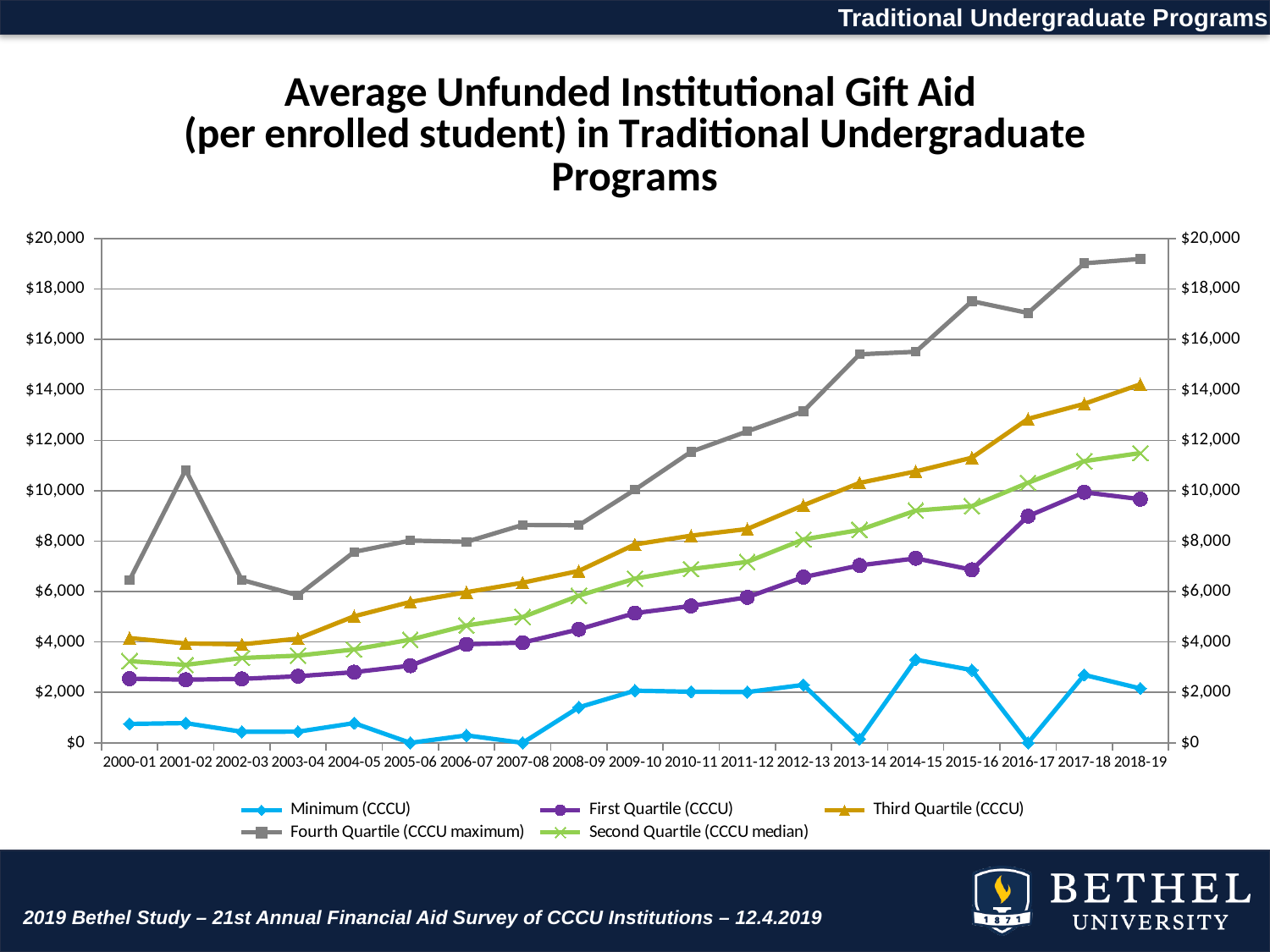
Is the Third Quartile (CCCU) value for 2000-01 greater or less than $6,000? less How many academic years are plotted along the x axis? 19 Which series has the highest value in 2018-19? Fourth Quartile (CCCU maximum) Is the Second Quartile (CCCU median) value for 2018-19 greater or less than $10,000? greater Does the Third Quartile (CCCU) series generally rise or fall from 2000-01 to 2018-19? rise Which series has the lowest values throughout the chart? Minimum (CCCU) In which year does the Minimum (CCCU) series reach its highest value? 2014-15 How many series does the legend list? 5 What kind of chart is shown on the slide? line chart For the Fourth Quartile (CCCU maximum) series, which is larger: the value for 2001-02 or the value for 2002-03? 2001-02 Is the Fourth Quartile (CCCU maximum) value for 2018-19 greater or less than $18,000? greater